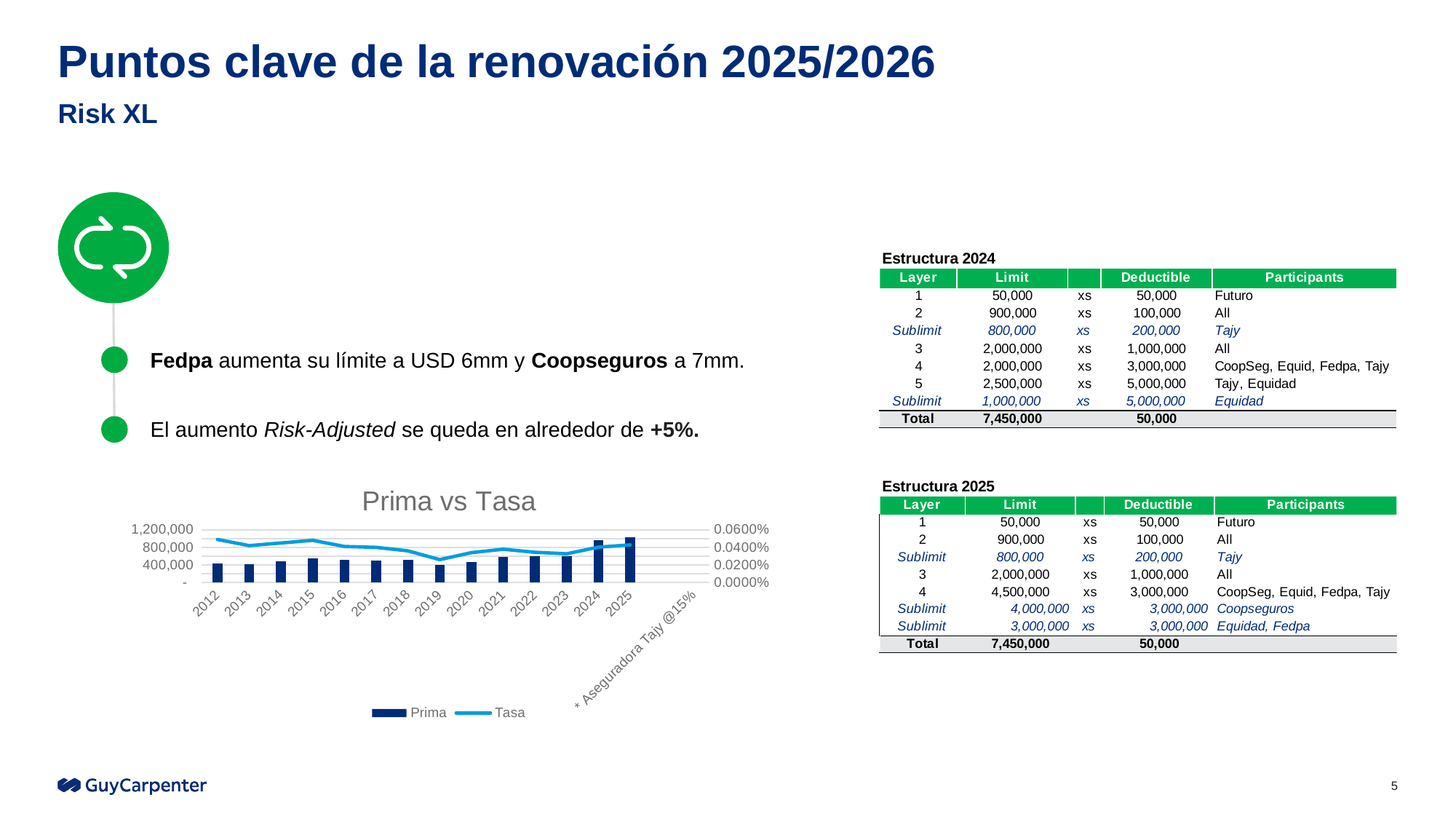
In the "Prima vs Tasa" chart, is the Tasa value for 2019 greater or less than 0.0400%? less In the "Prima vs Tasa" chart, is the Prima value for 2025 greater or less than 800,000? greater In the "Prima vs Tasa" chart, which series is drawn as a line? Tasa In the "Prima vs Tasa" chart, does the Tasa line rise or fall from 2012 to 2019? fall In the "Prima vs Tasa" chart, is the Prima value for 2015 greater or less than 400,000? greater In the "Prima vs Tasa" chart, which year has the highest Prima bar? 2025 How many years are shown on the x axis of the "Prima vs Tasa" chart? 14 What is the title of the chart on the slide? Prima vs Tasa In the "Prima vs Tasa" chart, which is larger, the Prima bar for 2025 or the Prima bar for 2012? 2025 How many series does the legend of the "Prima vs Tasa" chart list? 2 What kind of chart is "Prima vs Tasa"? Combined bar and line chart